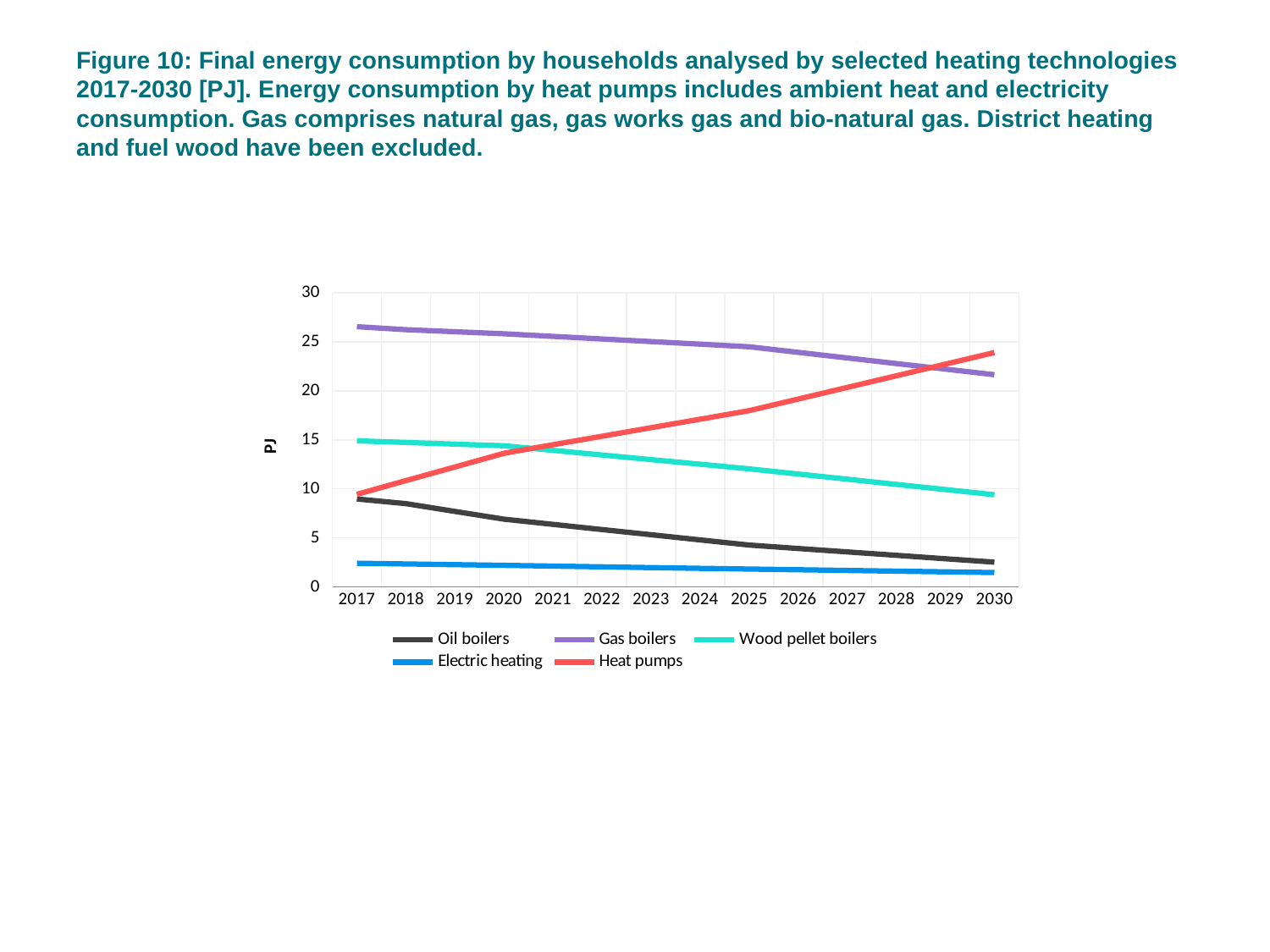
How many years are shown along the x axis? 14 How many series does the legend list? 5 Which series has the highest value in 2030? Heat pumps Which series has the lowest value in 2030? Electric heating Do the values for Heat pumps rise or fall from 2017 to 2030? Rise Is the value for Gas boilers in 2017 greater or less than 25? greater Which series has the highest value in 2017? Gas boilers In 2025, which is larger: Heat pumps or Wood pellet boilers? Heat pumps Is the value for Oil boilers in 2030 greater or less than 5? less Do the values for Oil boilers rise or fall from 2017 to 2030? Fall What kind of chart is shown on the slide? Line chart What is the label on the vertical axis? PJ